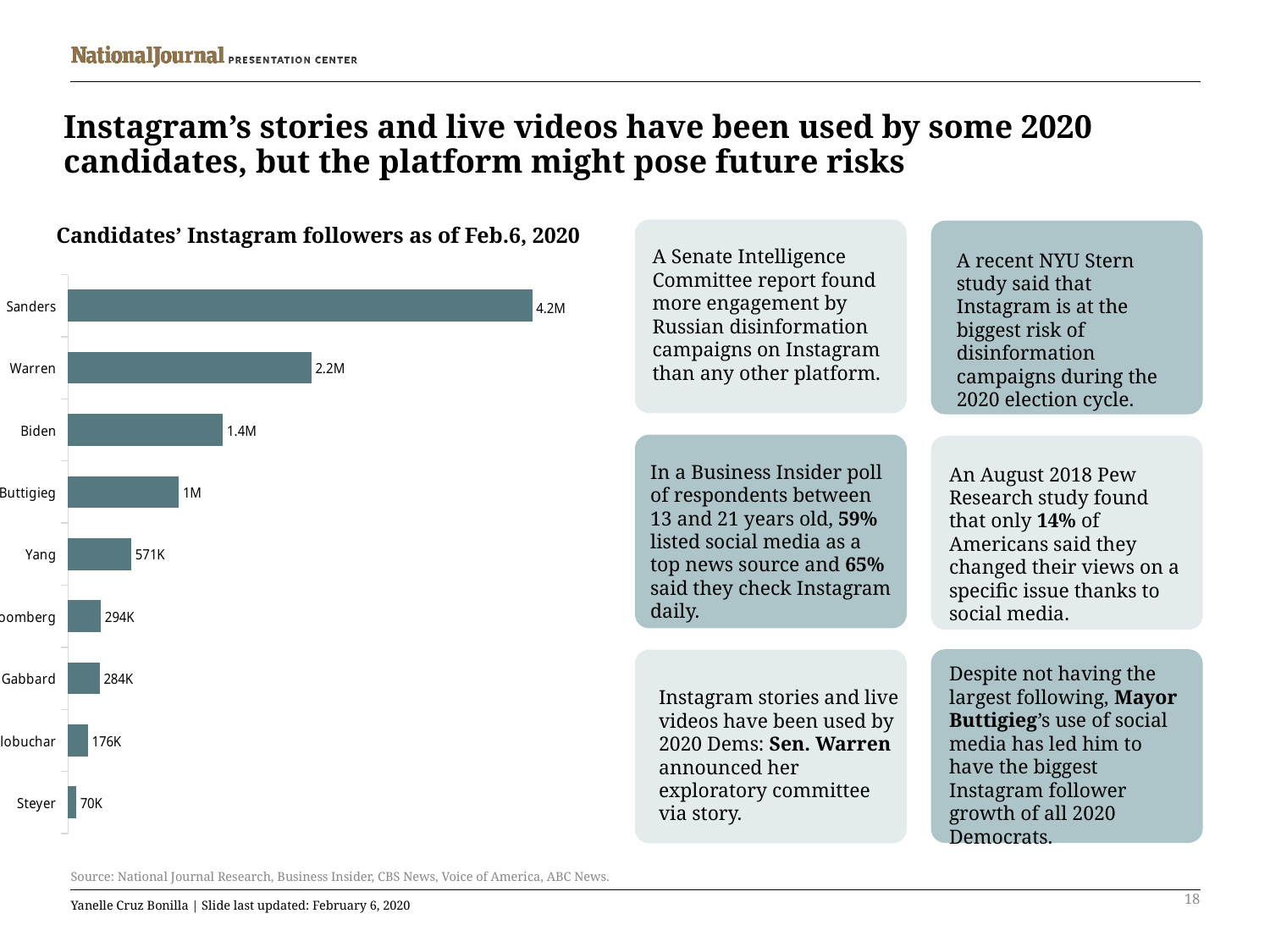
Which candidate has the fewest Instagram followers in the chart? Steyer How many Instagram followers does Biden have according to the chart? 1.4M How many Instagram followers does Steyer have according to the chart? 70K How many candidates are shown in the chart? 9 How many Instagram followers does Yang have according to the chart? 571K How many Instagram followers does Warren have according to the chart? 2.2M Who has more Instagram followers, Buttigieg or Gabbard? Buttigieg Which candidate has the most Instagram followers in the chart? Sanders What is the difference in Instagram followers between Sanders and Warren? 2M What kind of chart is shown on the slide? Bar chart What is the title of the chart on the slide? Candidates' Instagram followers as of Feb.6, 2020 How many Instagram followers does Sanders have according to the chart? 4.2M